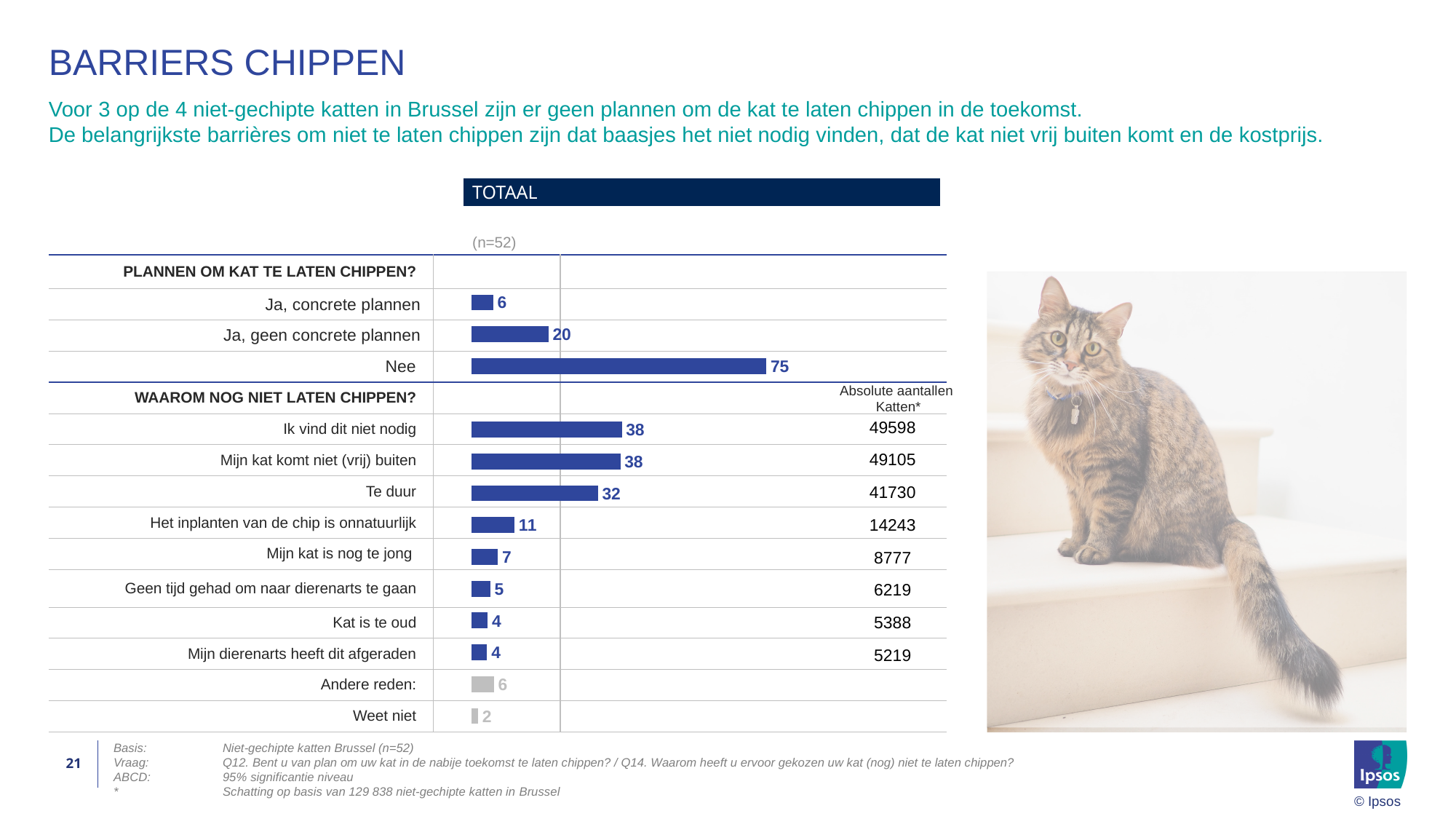
Which is larger: the value for "Te duur" or for "Mijn kat is nog te jong"? Te duur What is the value for "Nee" under "Plannen om kat te laten chippen?"? 75 What is the value for "Het inplanten van de chip is onnatuurlijk"? 11 How many reasons are listed under "Waarom nog niet laten chippen?"? 10 What is the difference between the values for "Ik vind dit niet nodig" and "Te duur"? 6 Which reason under "Waarom nog niet laten chippen?" has the lowest value? Weet niet What is the absolute number of cats ("Absolute aantallen Katten") shown for "Te duur"? 41730 What is the value for "Ja, concrete plannen"? 6 What kind of chart is shown on the slide? bar chart What is the difference between the values for "Nee" and "Ja, geen concrete plannen"? 55 What is the value for "Te duur" under "Waarom nog niet laten chippen?"? 32 Which category under "Plannen om kat te laten chippen?" has the highest value? Nee